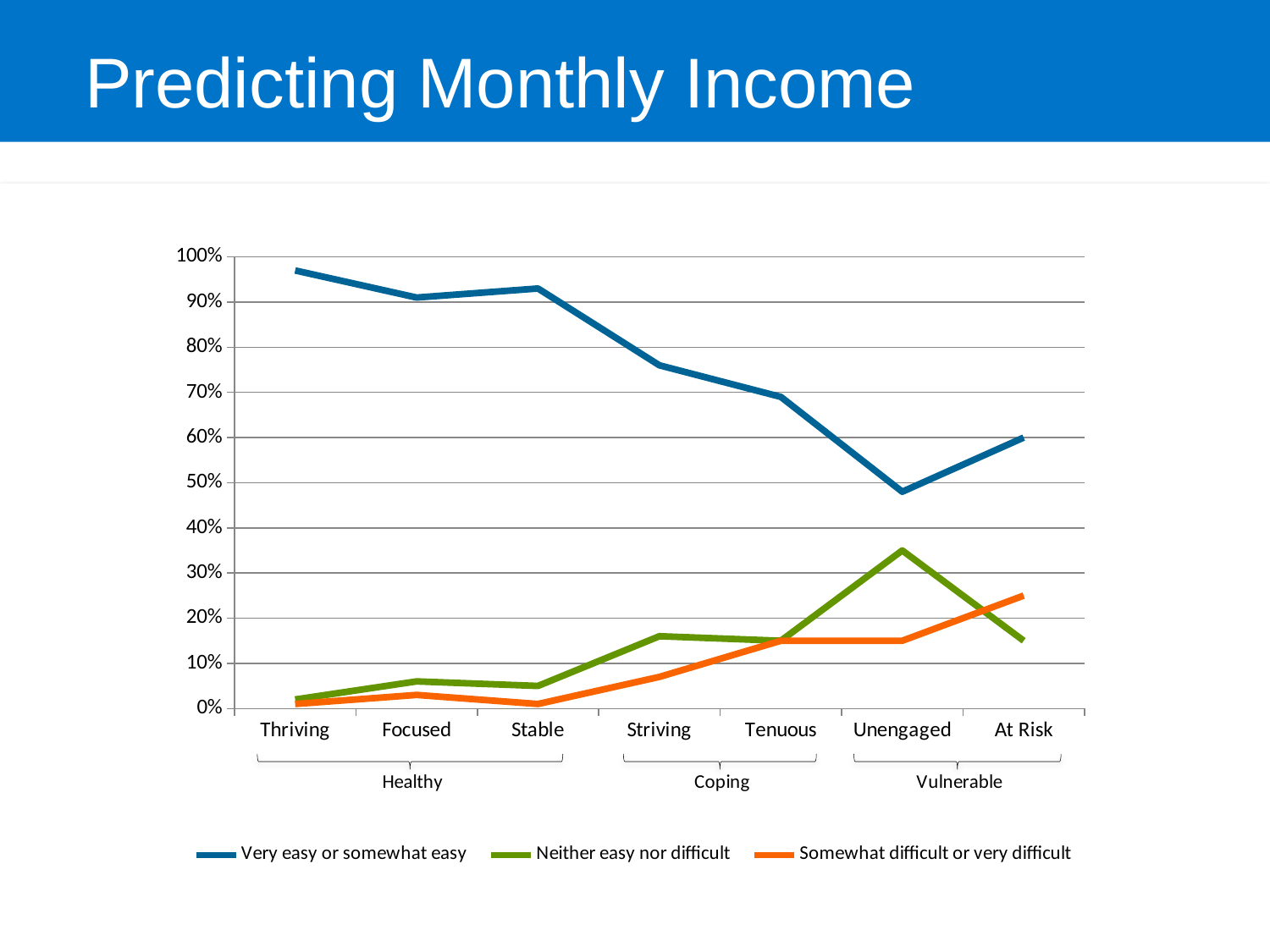
How many series does the legend list? 3 Is the value for 'Neither easy nor difficult' at Unengaged greater or less than 30%? greater Does the 'Very easy or somewhat easy' line generally rise or fall from Thriving to Unengaged? fall What are the three group labels shown beneath the x-axis categories? Healthy, Coping, Vulnerable For the 'Somewhat difficult or very difficult' series, which category has the highest value? At Risk For the 'Very easy or somewhat easy' series, which category has the highest value? Thriving Is the value for 'Very easy or somewhat easy' at Striving greater or less than 80%? less For the 'Neither easy nor difficult' series, which category has the highest value? Unengaged What kind of chart is shown on the slide? line chart How many categories are shown along the x axis? 7 At At Risk, which is larger: 'Somewhat difficult or very difficult' or 'Neither easy nor difficult'? Somewhat difficult or very difficult For the 'Very easy or somewhat easy' series, which category has the lowest value? Unengaged